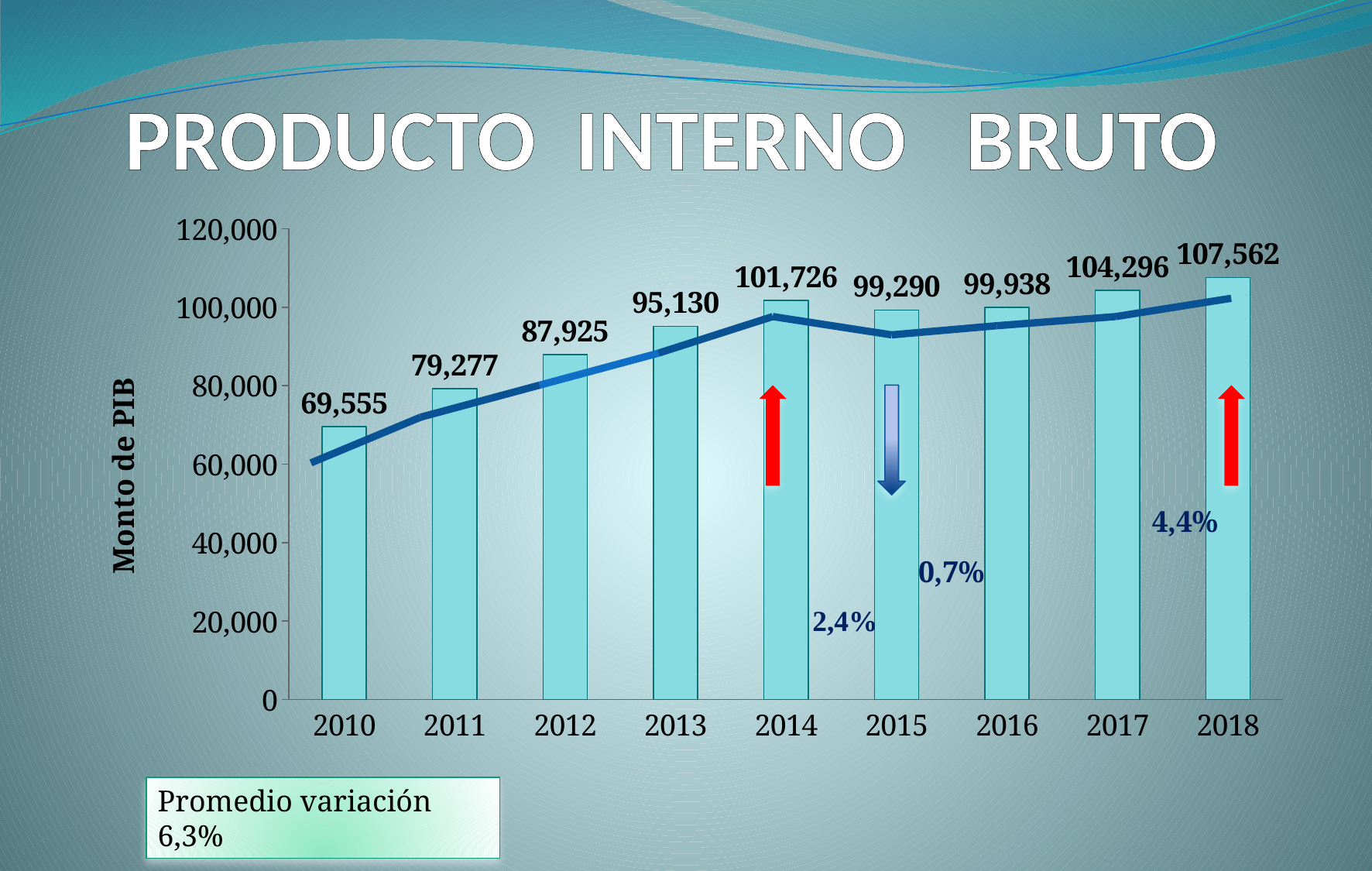
Which year has the lowest value? 2010 How many years are shown on the x axis? 9 Which year has the highest value? 2018 What kind of chart is shown on the slide? Bar chart with a line overlay What is the difference between the values for 2014 and 2015? 2,436 Is the value for 2012 greater or less than 80,000? greater What is the title of the slide? PRODUCTO INTERNO BRUTO Which is larger, the value for 2015 or the value for 2016? 2016 What is the value for 2017? 104,296 What is the difference between the values for 2018 and 2017? 3,266 What is the value for 2010? 69,555 What is the value for 2014? 101,726